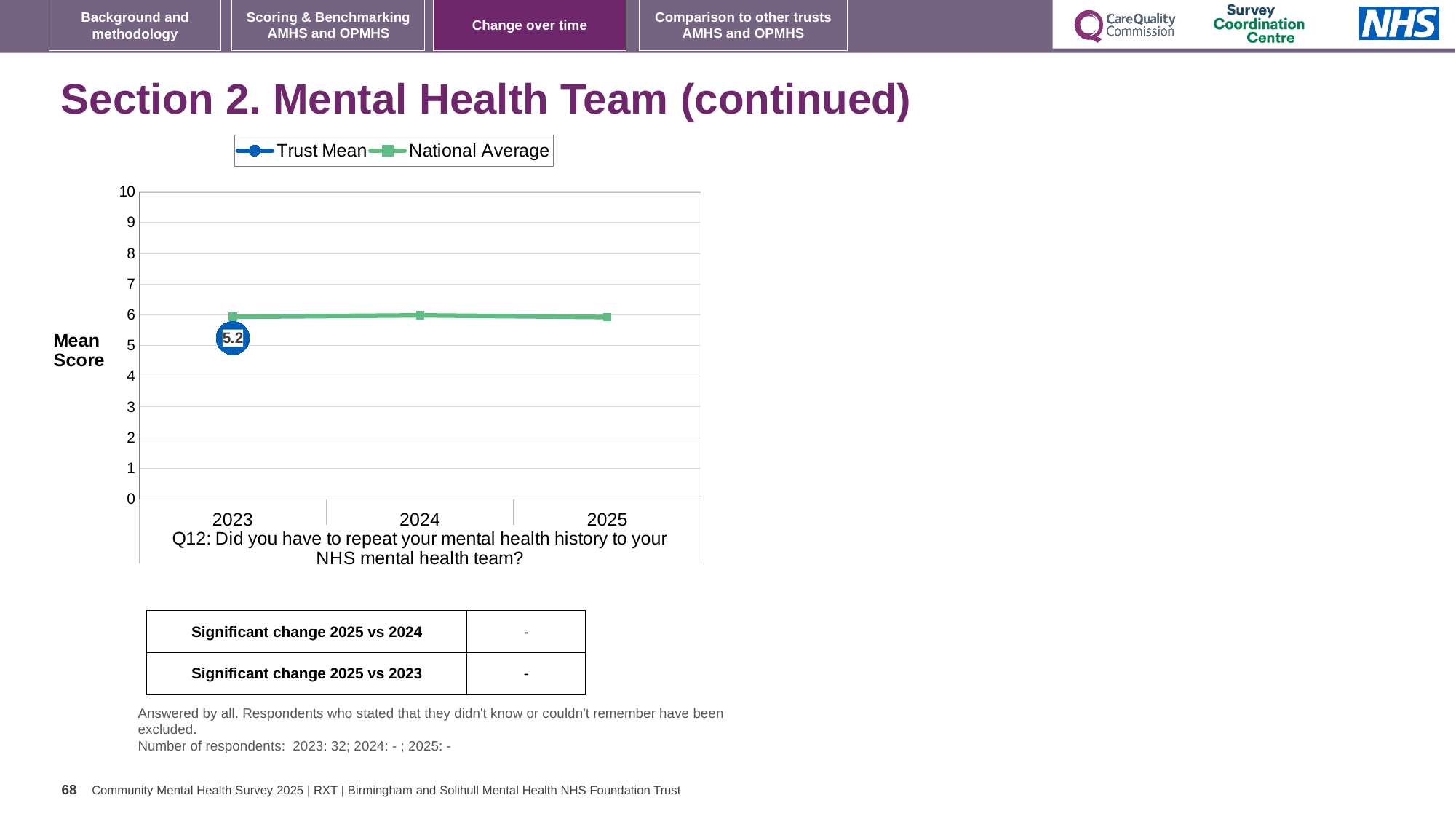
How many years are shown on the x axis? 3 Is the Trust Mean value for 2023 greater or less than 6? less What kind of chart is shown on the slide? line chart What are the two series named in the legend? Trust Mean and National Average Is the National Average value for 2024 greater or less than 5? greater What is the Trust Mean score for 2023? 5.2 What is the label on the y axis? Mean Score In 2023, which is larger: the Trust Mean or the National Average? National Average How many series does the legend list? 2 Is the National Average value for 2025 greater or less than 7? less For how many years is a Trust Mean point plotted? 1